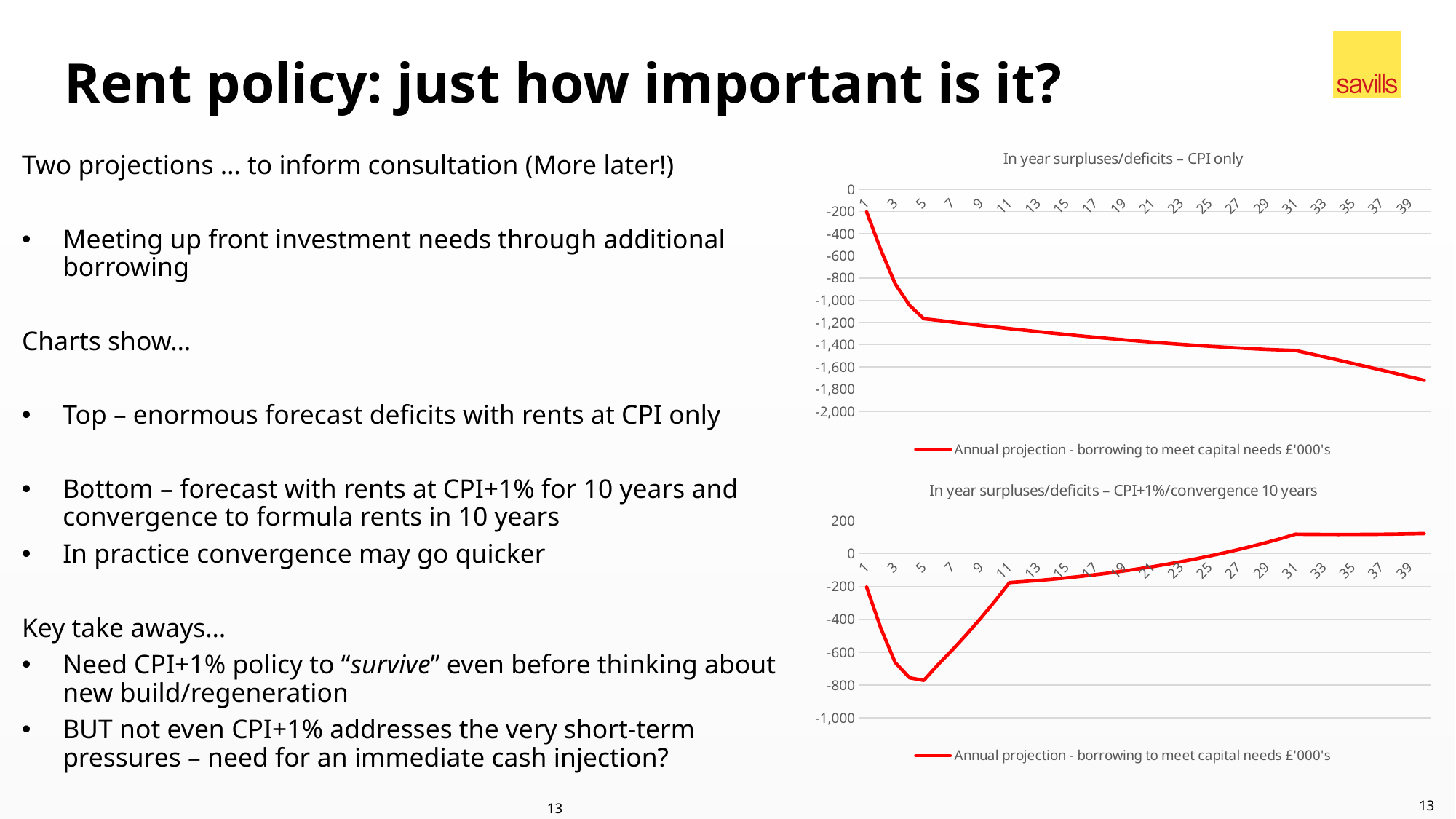
In the top chart 'In year surpluses/deficits – CPI only', do the values rise or fall as the years increase along the x axis? fall In the bottom chart 'In year surpluses/deficits – CPI+1%/convergence 10 years', at which year is the value lowest? 5 In the bottom chart 'In year surpluses/deficits – CPI+1%/convergence 10 years', which is larger, the value at year 1 or the value at year 5? year 1 In the top chart 'In year surpluses/deficits – CPI only', is the value at year 39 greater or less than -1,600? less In the top chart 'In year surpluses/deficits – CPI only', is the value at year 11 greater or less than -1,400? greater What is the legend entry shown under the top chart 'In year surpluses/deficits – CPI only'? Annual projection - borrowing to meet capital needs £'000's How many series does the legend of the bottom chart 'In year surpluses/deficits – CPI+1%/convergence 10 years' list? 1 What kind of chart is the top chart titled 'In year surpluses/deficits – CPI only'? line chart In the top chart 'In year surpluses/deficits – CPI only', is the value at year 5 greater or less than -1,000? less In the top chart 'In year surpluses/deficits – CPI only', at which year is the value lowest? 40